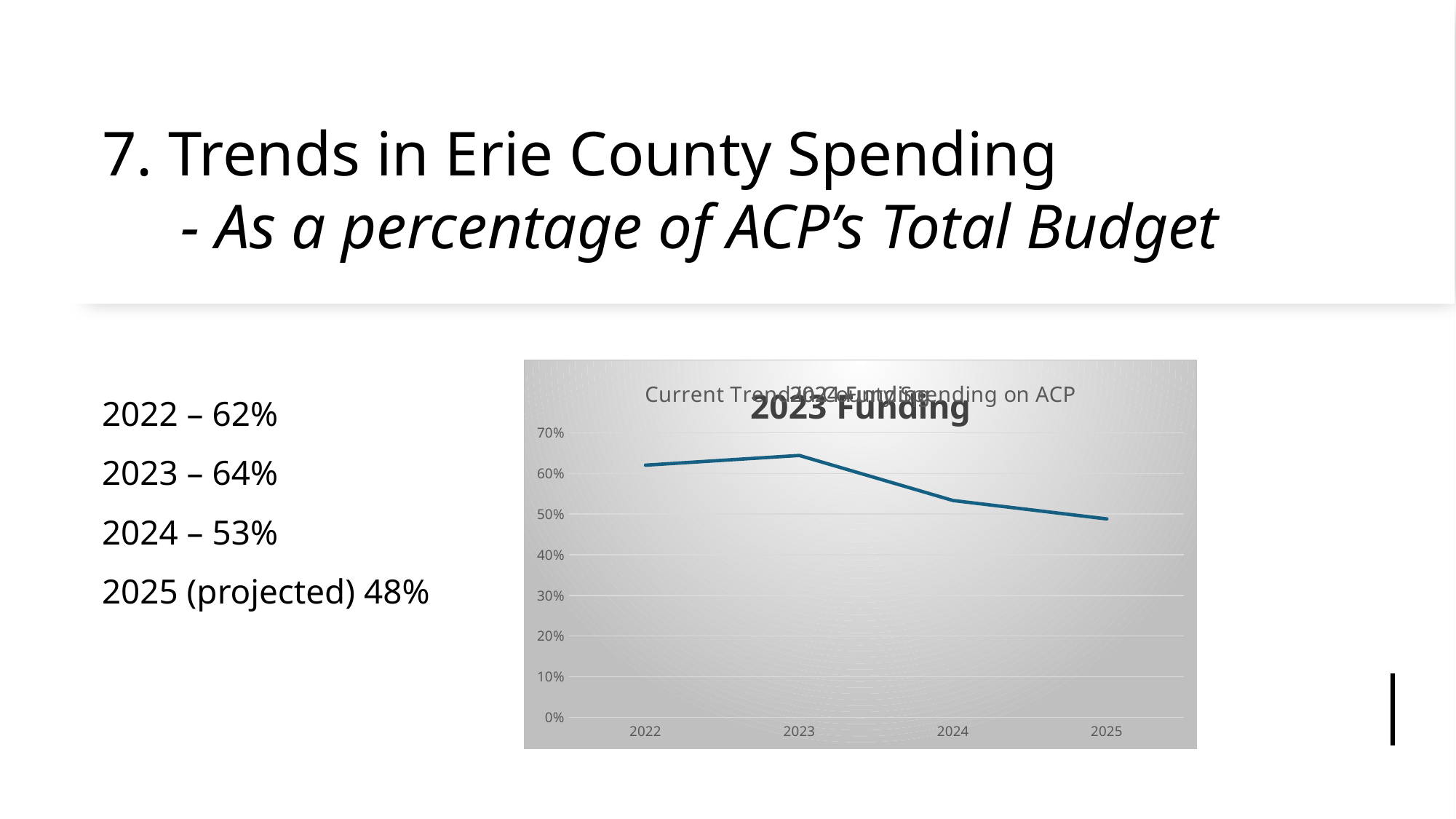
Which year has the highest value in the chart? 2023 What is the value for 2024 in the chart? 53% What is the projected value for 2025 in the chart? 48% What is the difference between the 2023 value and the 2025 value? 16 percentage points How many years are plotted along the x axis of the chart? 4 What kind of chart is shown on the slide? line chart Which year has the lowest value in the chart? 2025 Do the values rise or fall from 2023 to 2025? fall What is the highest tick label shown on the y axis of the chart? 70% Is the value for 2024 greater or less than 60%? less What is the value for 2022 in the chart? 62% Which year has the larger value, 2022 or 2024? 2022